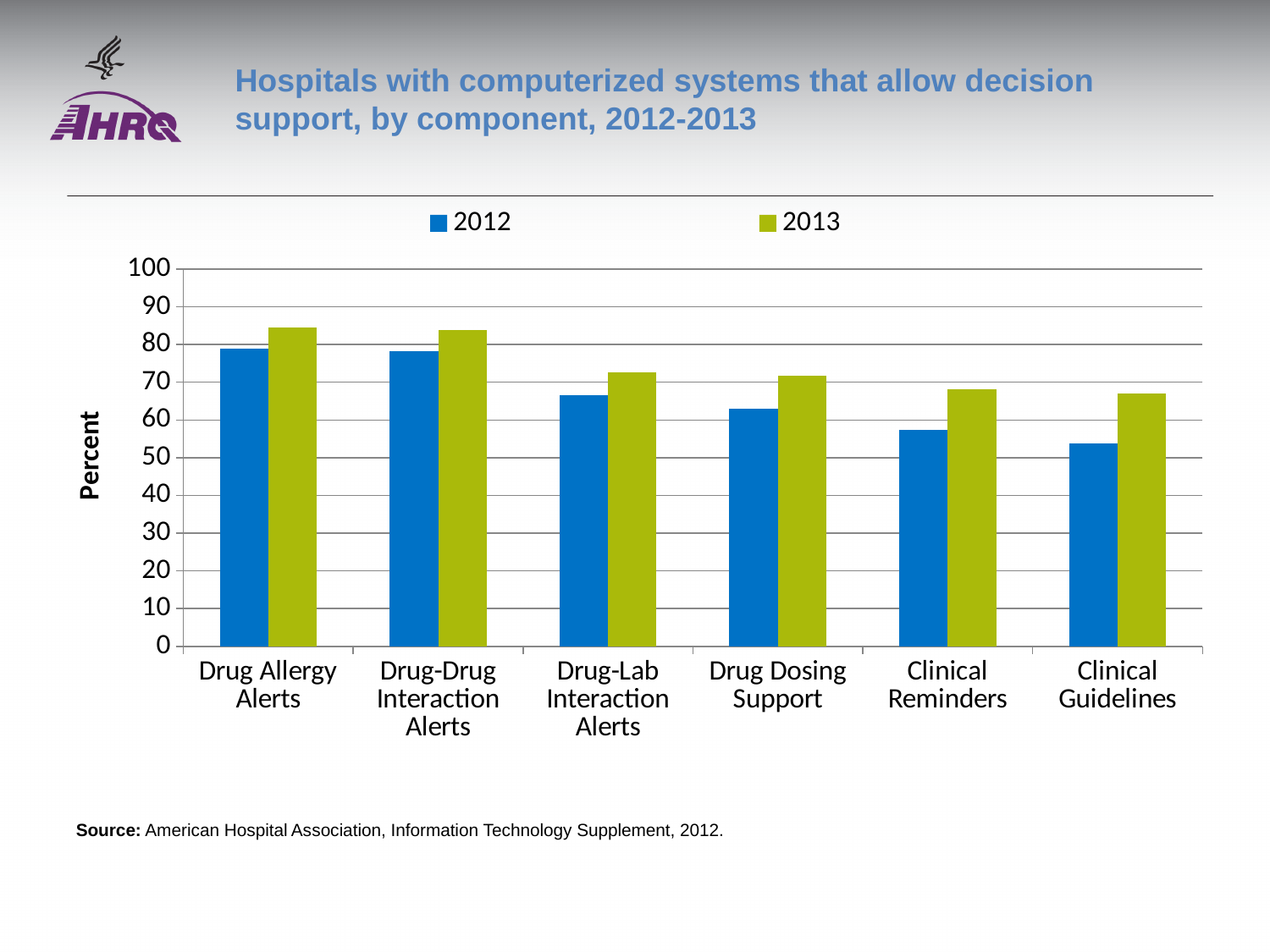
Is the 2013 value for Drug Allergy Alerts greater or less than 80? greater For Clinical Guidelines, which year has the larger value, 2012 or 2013? 2013 How many components (categories) are shown on the x axis? 6 Is the 2012 value for Drug Allergy Alerts greater or less than 70? greater What is the title of the vertical axis? Percent Do the 2012 values rise or fall moving from left to right across the components? fall What kind of chart is shown on the slide? bar chart How many series does the legend list? 2 Is the 2012 value for Drug Dosing Support greater or less than 60? greater Which component has the lowest 2012 value? Clinical Guidelines